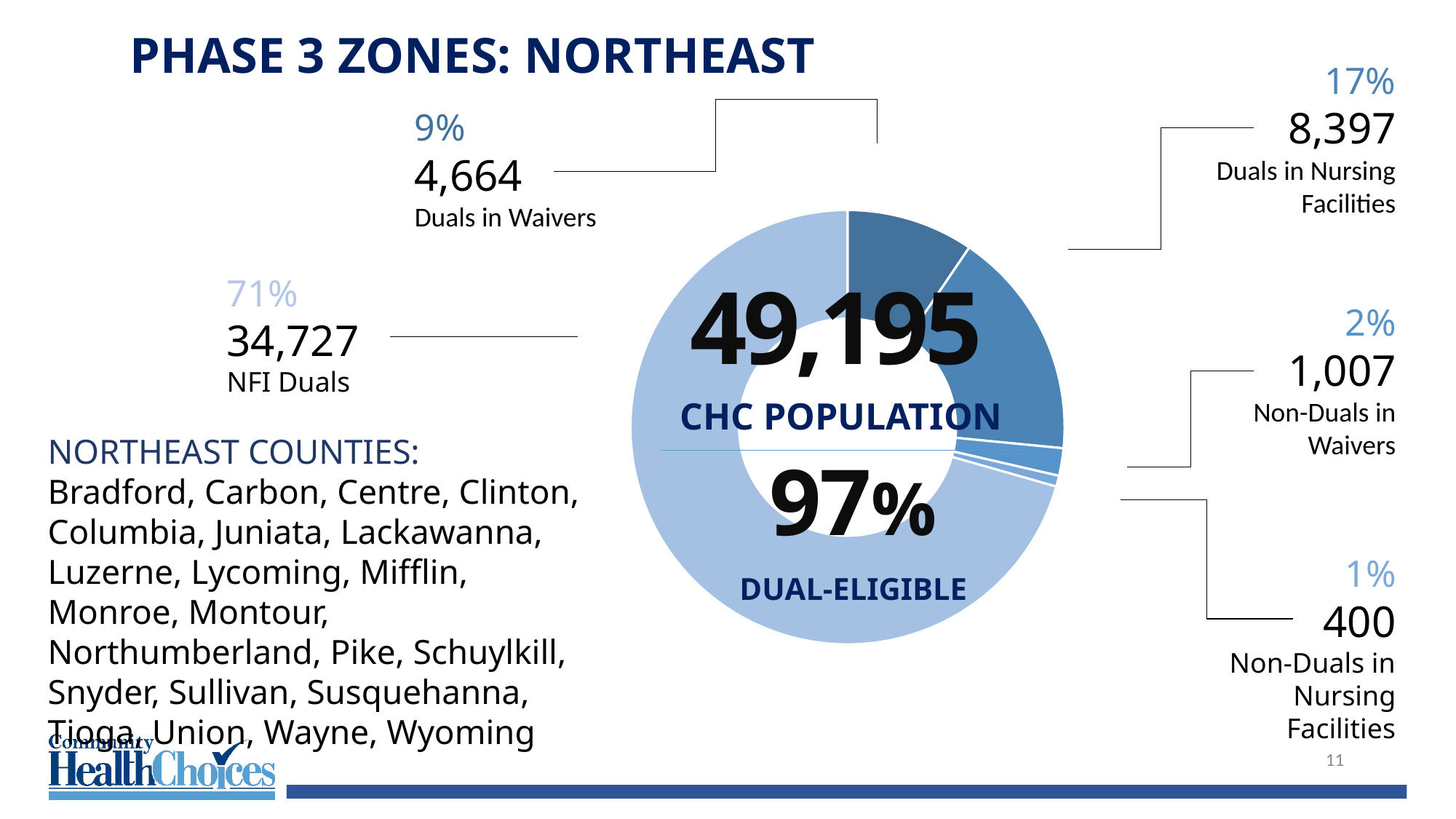
What total CHC population is shown in the centre of the chart? 49,195 What is the value for Non-Duals in Waivers? 1,007 Which category has the smallest slice? Non-Duals in Nursing Facilities How many categories does the pie chart have? 5 What is the value for Duals in Nursing Facilities? 8,397 What share of the pie is Non-Duals in Nursing Facilities? 1% What share of the pie is Duals in Waivers? 9% What kind of chart is shown on the slide? Pie (donut) chart What is the value for NFI Duals? 34,727 Which is larger, Non-Duals in Waivers or Non-Duals in Nursing Facilities? Non-Duals in Waivers What is the difference between Duals in Nursing Facilities and Duals in Waivers? 3,733 Which category has the largest slice? NFI Duals